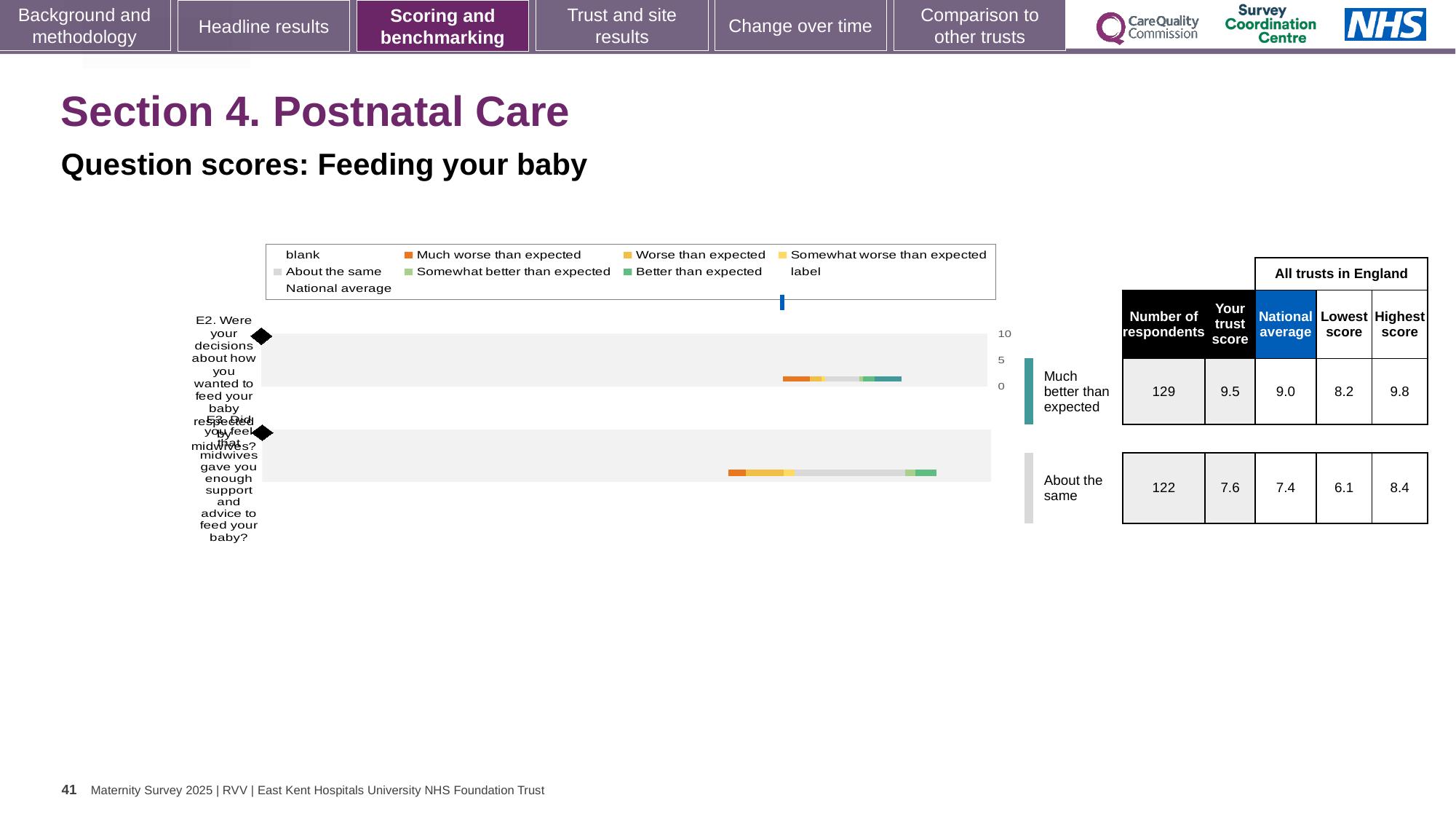
Which legend entry is shown in orange? Much worse than expected Which benchmark category is E3 rated as in the chart? About the same According to the table beside the chart, what is the trust score for E2 (decisions about how you wanted to feed your baby respected by midwives)? 9.5 According to the table beside the chart, how many respondents answered E2? 129 For E2, is the trust score higher or lower than the national average? higher How many questions (bars) are plotted in the chart? 2 Which benchmark category is E2 rated as in the chart? Much better than expected What is the difference between the highest score and the lowest score for E3 in the table beside the chart? 2.3 Which legend entry is shown in light grey? About the same According to the table beside the chart, what is the national average for E3 (midwives gave you enough support and advice to feed your baby)? 7.4 What kind of chart is shown on the slide? bar chart According to the table beside the chart, what is the lowest score among all trusts in England for E3? 6.1